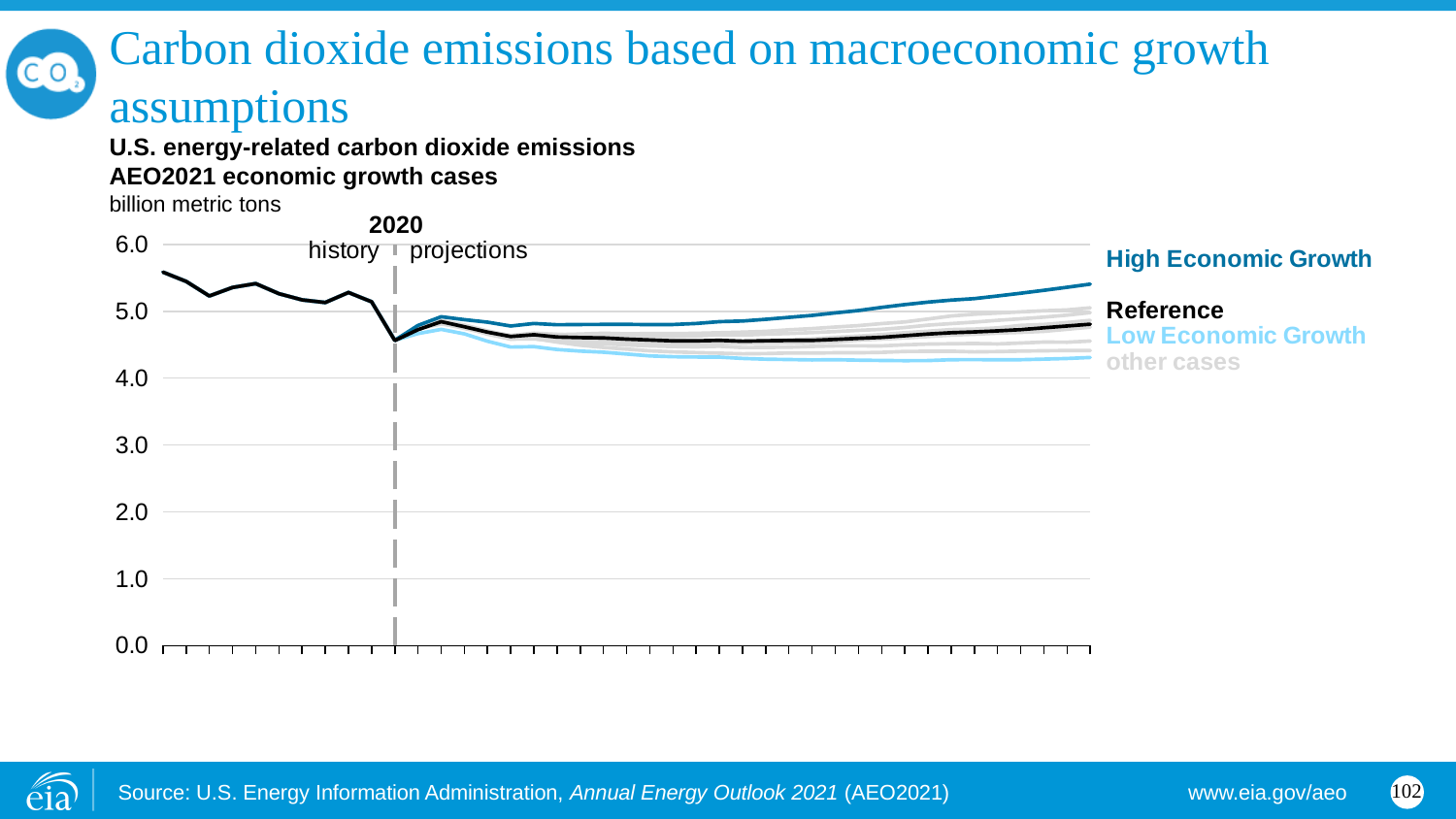
At the end of the projection period, is the value for the Reference case greater or less than 4.0? greater Which case has the lowest emissions at the end of the projection period? Low Economic Growth What is the title printed above the chart? U.S. energy-related carbon dioxide emissions AEO2021 economic growth cases Which year marks the boundary between history and projections on the chart? 2020 At the end of the projection period, is the value for High Economic Growth greater or less than 5.0? greater At the end of the projection period, which is larger: the High Economic Growth case or the Low Economic Growth case? High Economic Growth What kind of chart is shown on the slide? line chart Which case has the highest emissions at the end of the projection period? High Economic Growth Do emissions rise or fall over the history portion of the chart, from the start of the series to 2020? fall How many case labels are listed to the right of the chart? 4 What unit is used for the y axis of the chart? billion metric tons At the end of the projection period, is the value for Low Economic Growth greater or less than 5.0? less